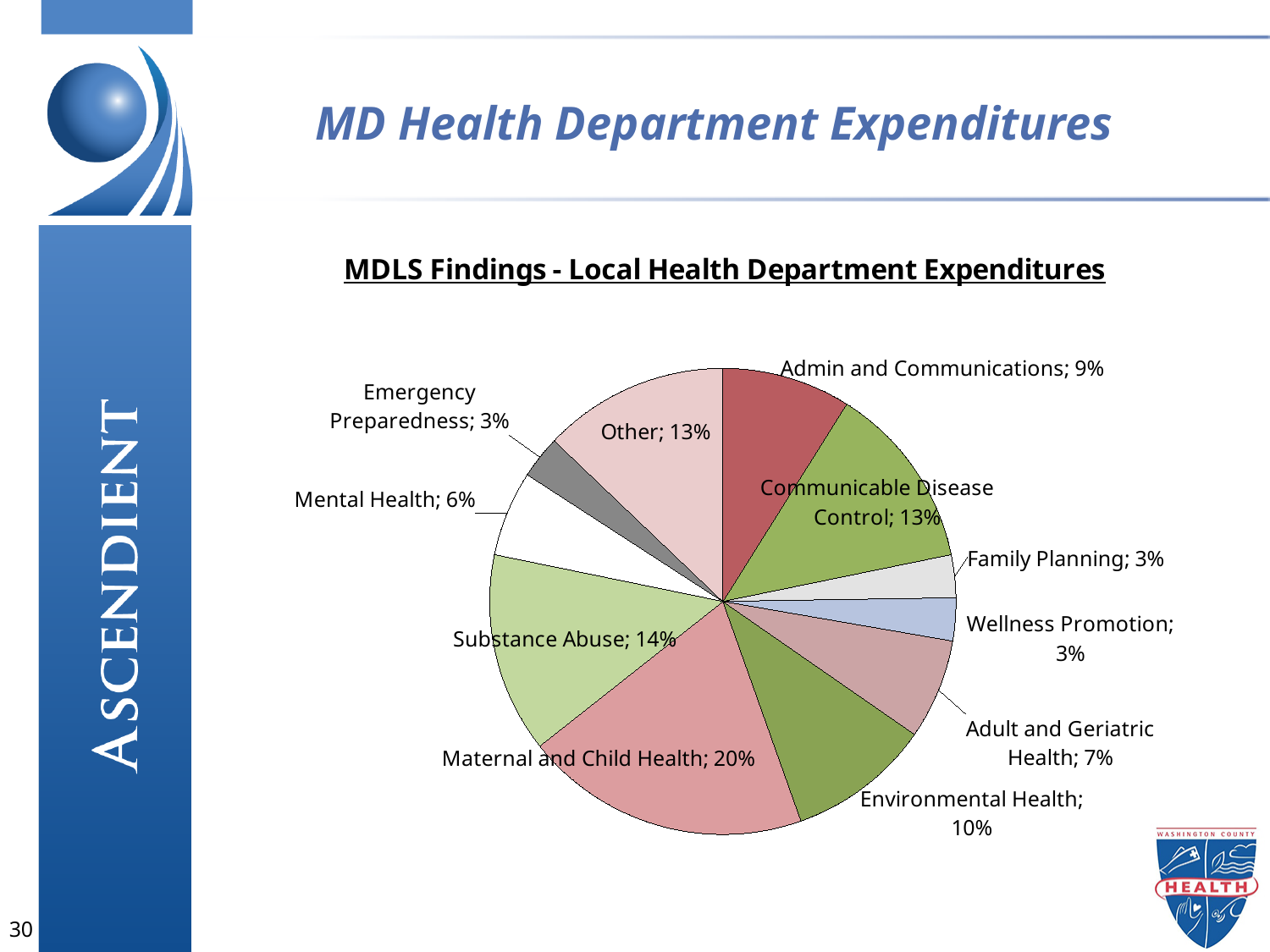
What percentage is shown for Adult and Geriatric Health? 7% How many categories are labelled with 3%? 3 How many slices does the pie chart have? 11 What is the title of the chart? MDLS Findings - Local Health Department Expenditures What percentage is shown for Environmental Health? 10% What is the combined share of Other and Emergency Preparedness? 16% What share of expenditures goes to Maternal and Child Health? 20% Which category has the largest share of expenditures? Maternal and Child Health What share is labelled for Communicable Disease Control? 13% What kind of chart is shown on the slide? pie chart Which is larger, the share for Admin and Communications or the share for Adult and Geriatric Health? Admin and Communications What is the difference in percentage points between Substance Abuse and Mental Health? 8